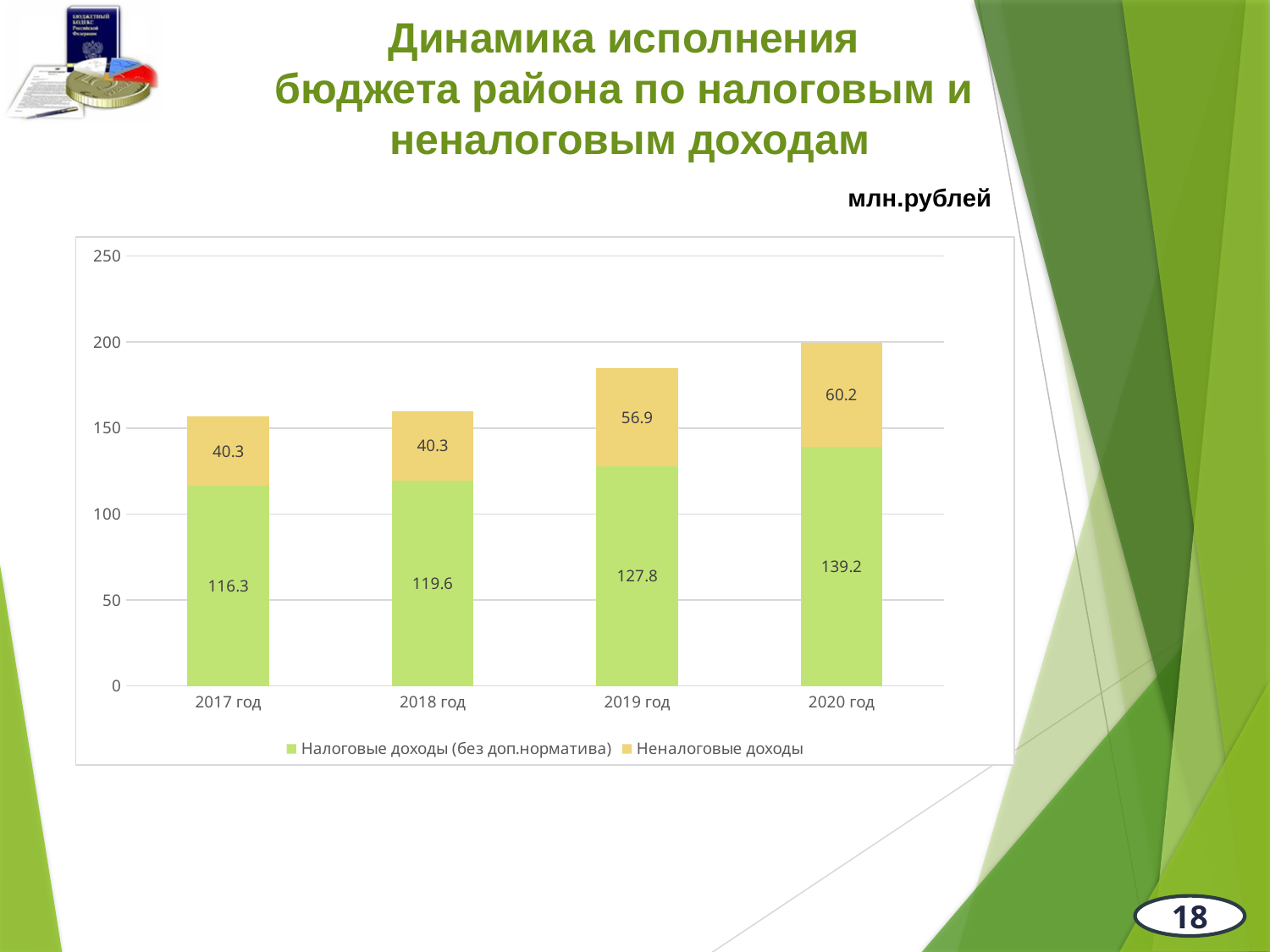
What is the total of the stacked bar for 2017 год? 156.6 What is the value of Налоговые доходы (без доп.норматива) for 2020 год? 139.2 Which year has the highest value of Неналоговые доходы? 2020 год What is the difference between Налоговые доходы (без доп.норматива) in 2020 год and 2019 год? 11.4 What is the value of Налоговые доходы (без доп.норматива) for 2017 год? 116.3 What is the total of the stacked bar for 2020 год? 199.4 How many series does the legend list? 2 Do the values of Налоговые доходы (без доп.норматива) rise or fall from 2017 год to 2020 год? rise Which is larger: Неналоговые доходы in 2019 год or in 2018 год? 2019 год What is the value of Неналоговые доходы for 2019 год? 56.9 How many years are shown on the x axis? 4 Which year has the lowest value of Налоговые доходы (без доп.норматива)? 2017 год